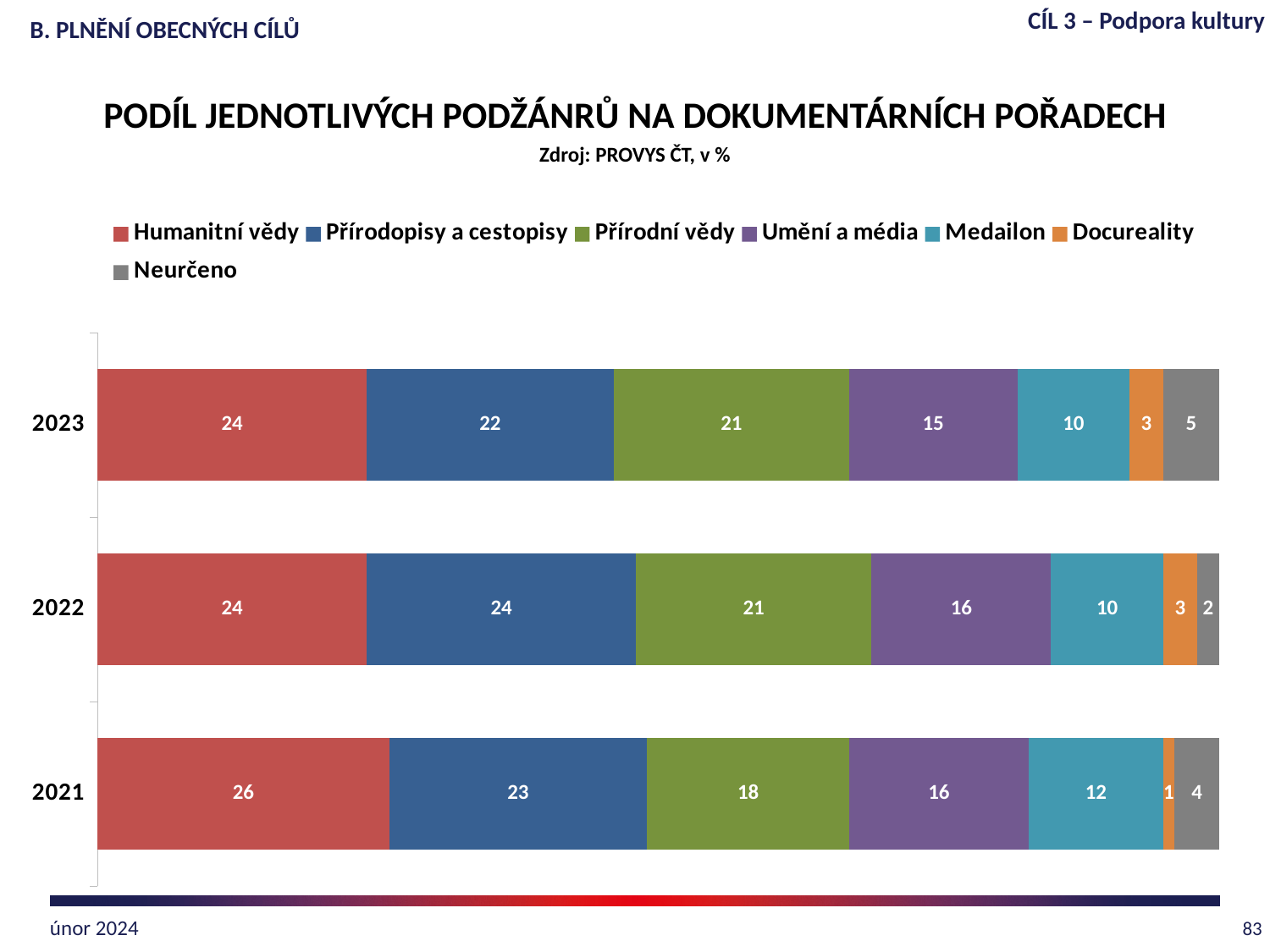
What is the value for Neurčeno in 2022? 2 How many series does the legend list? 7 Which subgenre has the highest share in 2023? Humanitní vědy What is the value for Medailon in 2023? 10 Which subgenre has the lowest share in 2021? Docureality How many years are shown on the chart? 3 What is the value for Humanitní vědy in 2021? 26 What is the total of the stacked bar for 2022? 100 What is the difference between Přírodní vědy in 2023 and Přírodní vědy in 2021? 3 Which is larger: Umění a média in 2022 or Umění a média in 2023? Umění a média in 2022 What is the value for Docureality in 2021? 1 What kind of chart is shown on the slide? Stacked bar chart